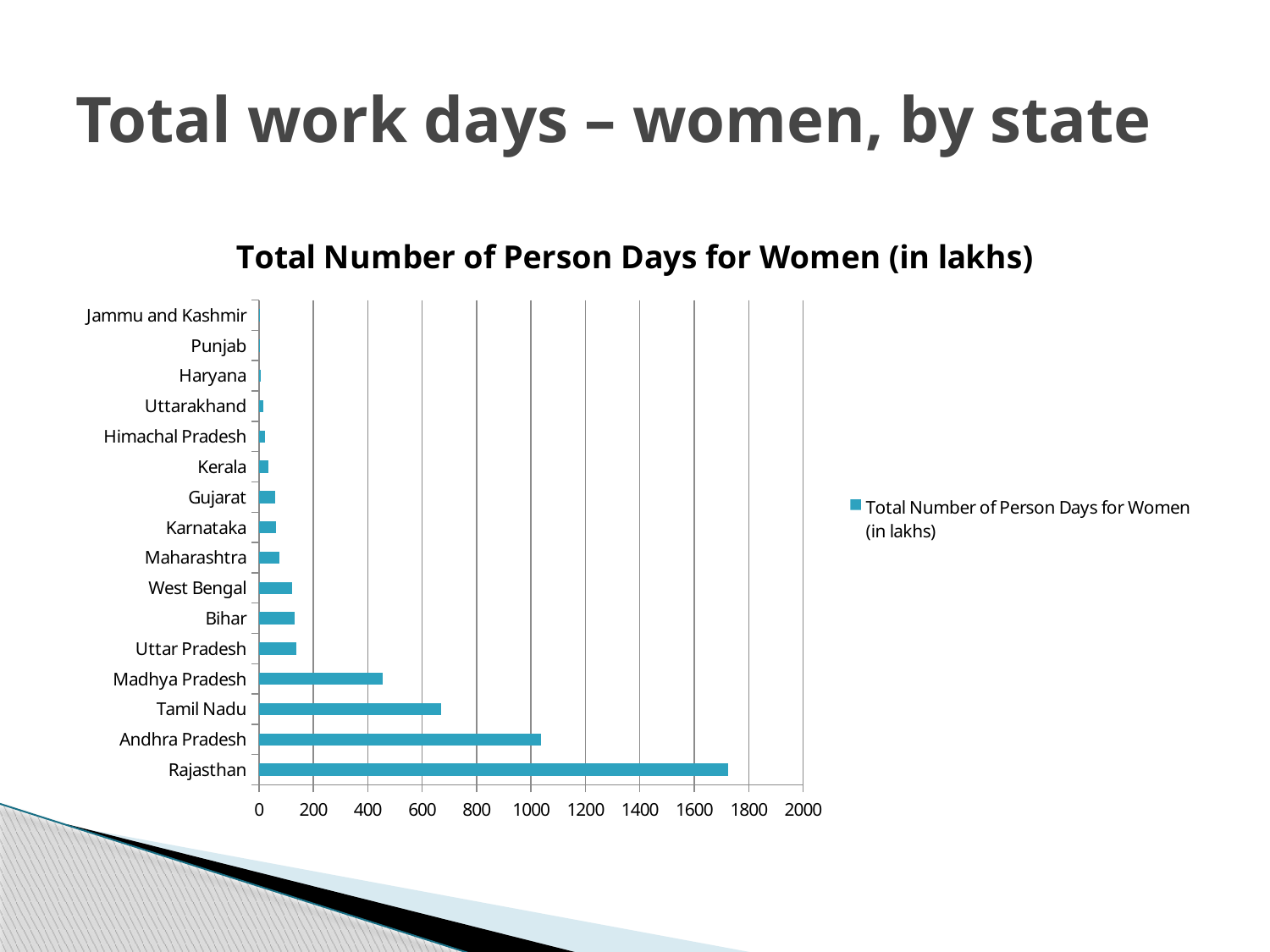
Is the value for Uttar Pradesh greater or less than 200? less Which has a larger value, Madhya Pradesh or West Bengal? Madhya Pradesh Which has a larger value, Andhra Pradesh or Tamil Nadu? Andhra Pradesh Is the value for Madhya Pradesh greater or less than 400? greater Is the value for Tamil Nadu greater or less than 800? less How many series does the legend list? 1 What is the title of the chart? Total Number of Person Days for Women (in lakhs) What type of chart is shown on the slide? Bar chart How many states are shown on the chart? 16 Which state has the highest total number of person days for women? Rajasthan